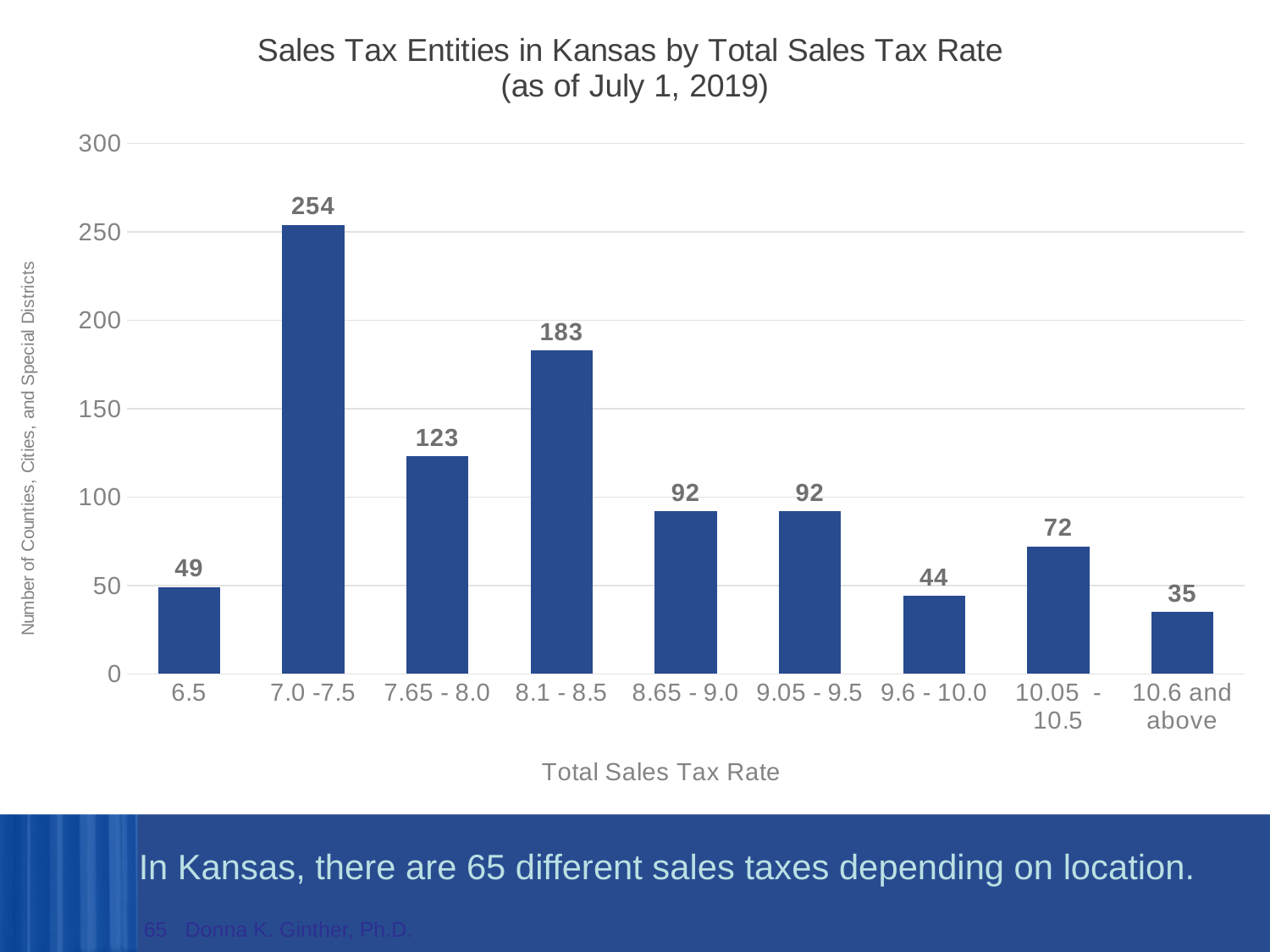
What is the title of the chart? Sales Tax Entities in Kansas by Total Sales Tax Rate (as of July 1, 2019) How many entities fall in the 10.6 and above category? 35 What is the difference between the number of entities in the 7.0 -7.5 category and the 8.1 - 8.5 category? 71 Which category has more entities: 9.6 - 10.0 or 10.05 - 10.5? 10.05 - 10.5 Which total sales tax rate category has the highest number of entities? 7.0 -7.5 What is the difference between the number of entities in the 7.65 - 8.0 category and the 6.5 category? 74 How many total sales tax rate categories are shown on the x axis? 9 Which total sales tax rate category has the lowest number of entities? 10.6 and above What kind of chart is shown on the slide? Bar chart What is the number of counties, cities, and special districts in the 8.1 - 8.5 rate category? 183 What is the label of the y axis? Number of Counties, Cities, and Special Districts How many sales tax entities have a total sales tax rate of 7.0 -7.5? 254